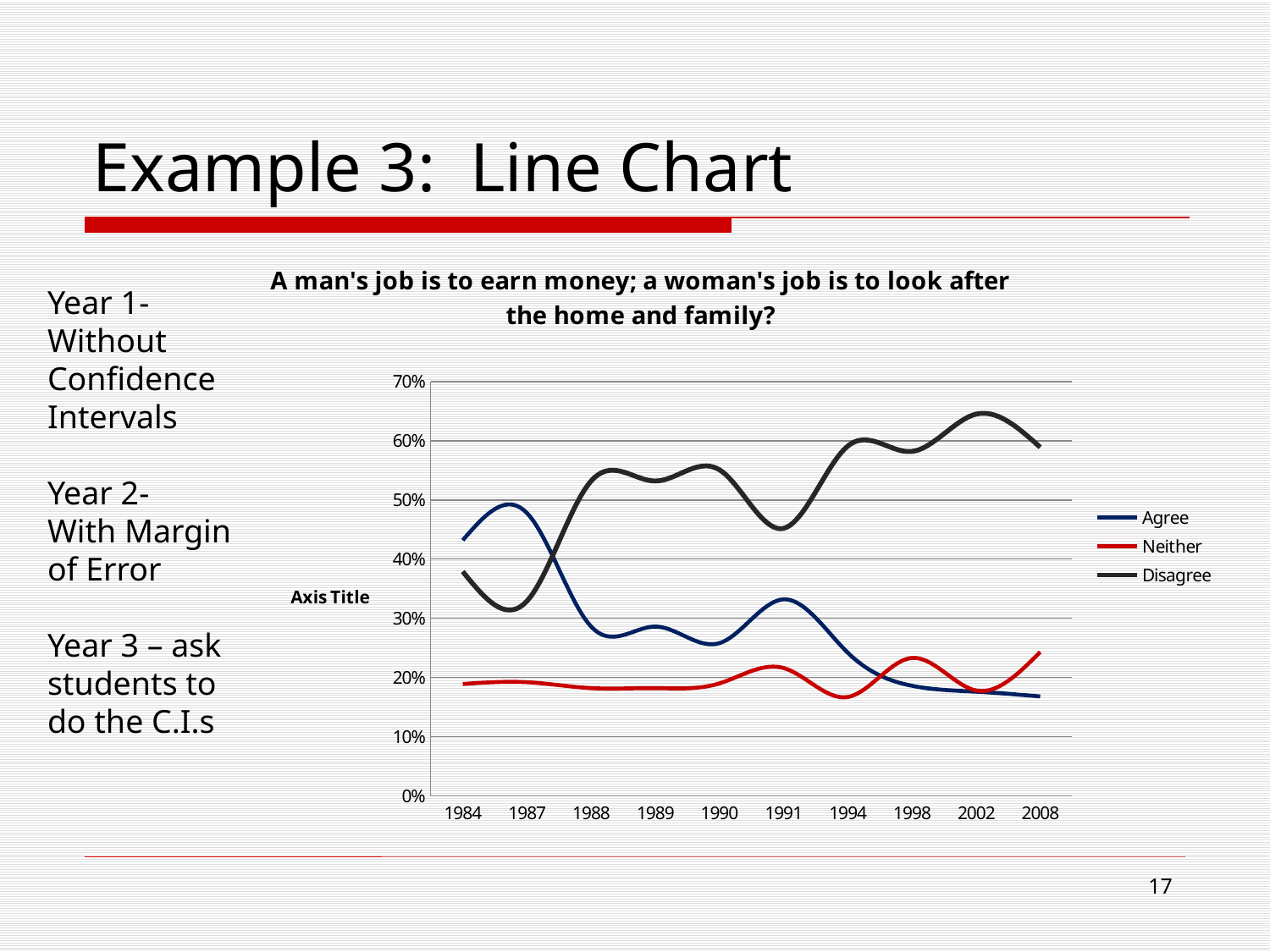
Is the value for Agree in 1990 greater or less than 30%? less Is the value for Agree in 2008 greater or less than 20%? less How many series does the legend list? 3 Is the value for Disagree in 1984 greater or less than 40%? less How many years are shown on the x axis? 10 What are the names of the series in the legend? Agree, Neither, Disagree What is the title of the chart? A man's job is to earn money; a woman's job is to look after the home and family? In 2008, which series has the larger value, Agree or Disagree? Disagree What kind of chart is shown on the slide? line chart In which year is the Disagree series at its highest? 2002 Does the Agree series generally rise or fall from 1984 to 2008? fall